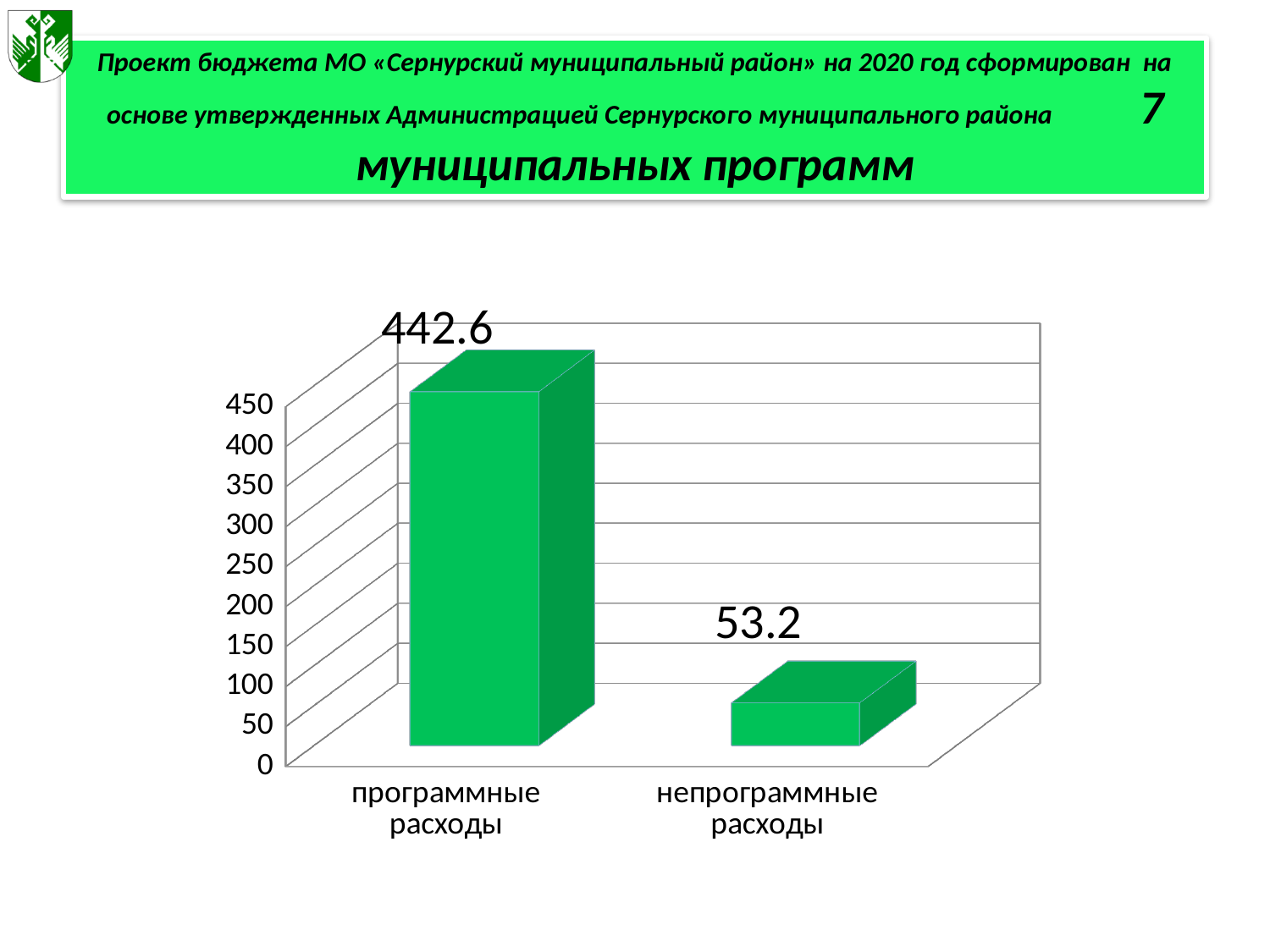
What is the value for программные расходы? 442.6 Is the value for непрограммные расходы greater or less than 100? less Is the value for программные расходы greater or less than 400? greater Which category has the lowest value? непрограммные расходы How many categories are shown on the chart? 2 Which is larger, программные расходы or непрограммные расходы? программные расходы What is the maximum value shown on the vertical axis? 450 Which category has the highest value? программные расходы What is the value for непрограммные расходы? 53.2 What colour are the bars in the chart? green What is the difference between the values for программные расходы and непрограммные расходы? 389.4 What kind of chart is shown on the slide? bar chart